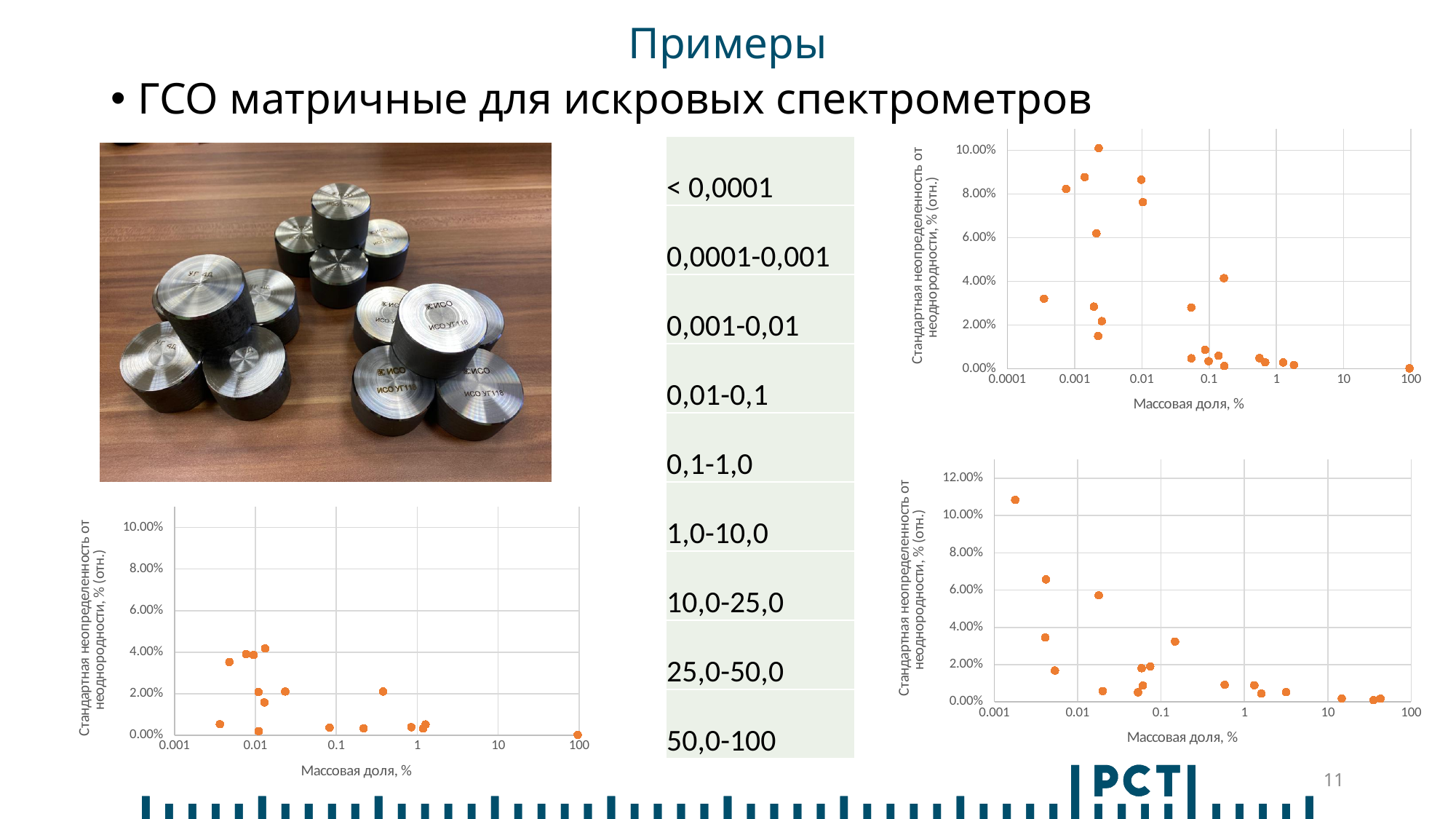
In the bottom-right chart, is the highest plotted point greater or less than 10.00%? greater In the top-right chart, is the highest plotted point greater or less than 8.00%? greater What is the label of the x axis on the bottom-left chart? Массовая доля, % In the top-right chart, do the plotted values generally rise or fall as the mass fraction increases along the x axis? fall In the top-right chart, is the point plotted at a mass fraction of 100 greater or less than 2.00%? less What kind of chart is the top-right chart on the slide? scatter chart In the bottom-right chart, do the plotted values generally rise or fall as the mass fraction increases along the x axis? fall What is the highest tick value shown on the y axis of the bottom-right chart? 12.00% What kind of chart is the bottom-left chart on the slide? scatter chart